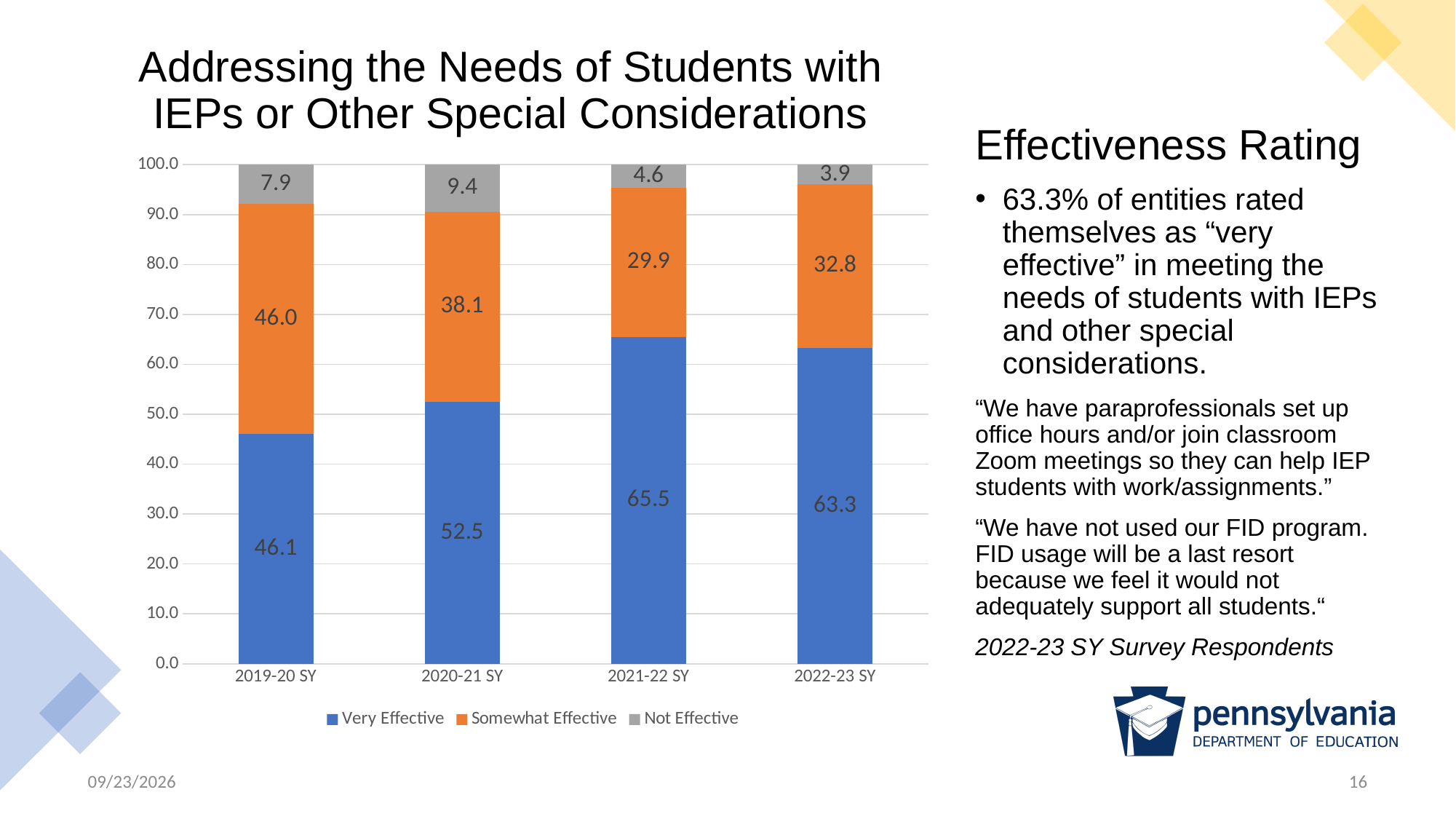
Which colour represents the Not Effective series in the legend? Grey What is the Very Effective value for 2021-22 SY? 65.5 What kind of chart is shown on the slide? Stacked bar chart Which school year has the highest Very Effective value? 2021-22 SY What is the total of the stacked bar for 2021-22 SY? 100.0 What is the Somewhat Effective value for 2019-20 SY? 46.0 How many series does the legend list? 3 What is the difference between the Very Effective values for 2022-23 SY and 2019-20 SY? 17.2 Which school year has the lowest Not Effective value? 2022-23 SY What is the Not Effective value for 2020-21 SY? 9.4 Which is larger, the Somewhat Effective value for 2020-21 SY or for 2022-23 SY? 2020-21 SY How many school years are shown on the x axis? 4